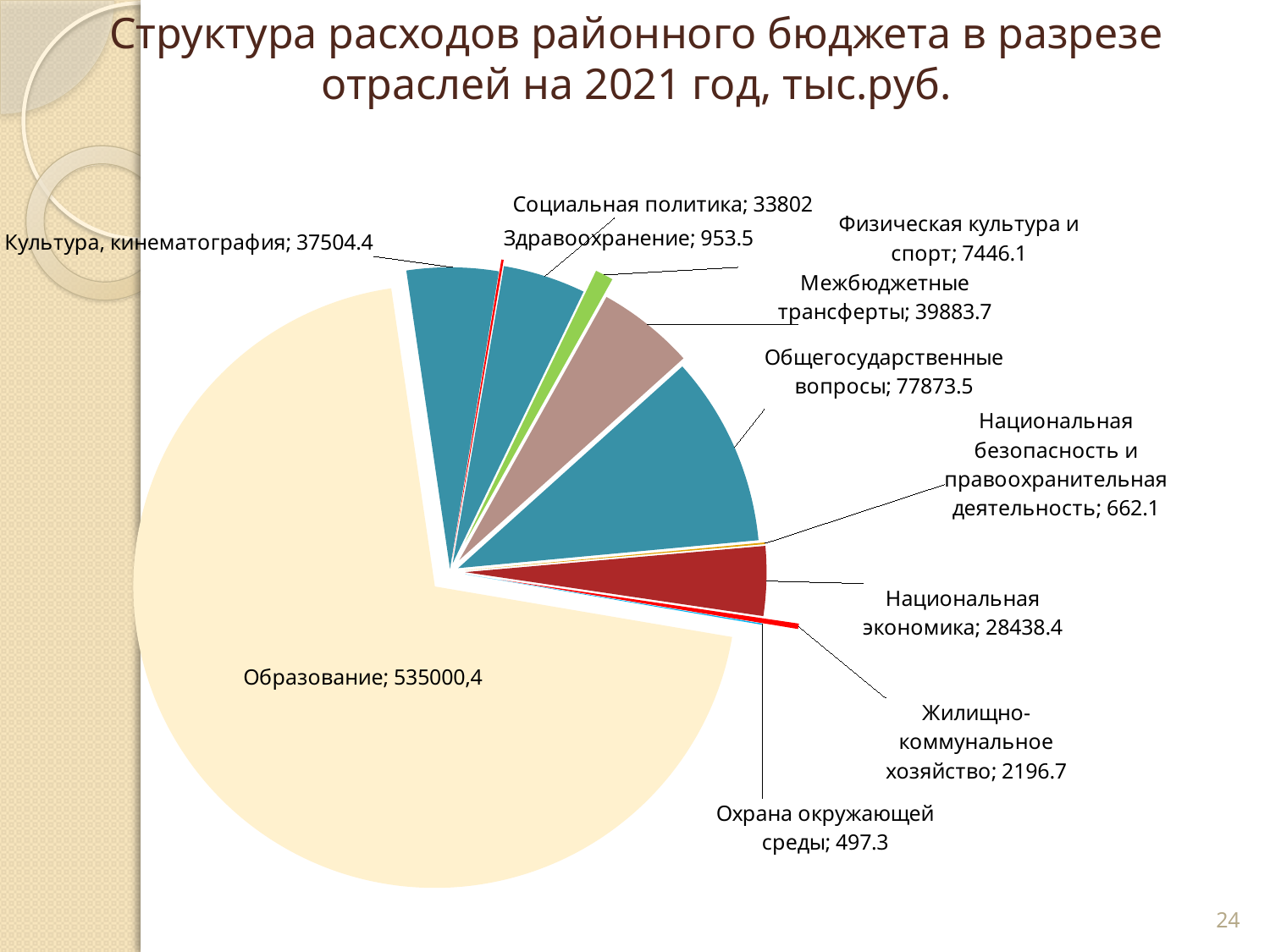
What is the value for Образование? 535000,4 What is the value for Охрана окружающей среды? 497.3 What is the value for Общегосударственные вопросы? 77873.5 What is the difference between Общегосударственные вопросы and Межбюджетные трансферты? 37989.8 Which is larger: Социальная политика or Национальная экономика? Социальная политика What is the value for Межбюджетные трансферты? 39883.7 Which category has the largest value? Образование What is the value for Национальная экономика? 28438.4 Which category has the smallest value? Охрана окружающей среды What is the title of the chart? Структура расходов районного бюджета в разрезе отраслей на 2021 год, тыс.руб. How many categories are shown in the pie chart? 11 What kind of chart is shown on the slide? Pie chart